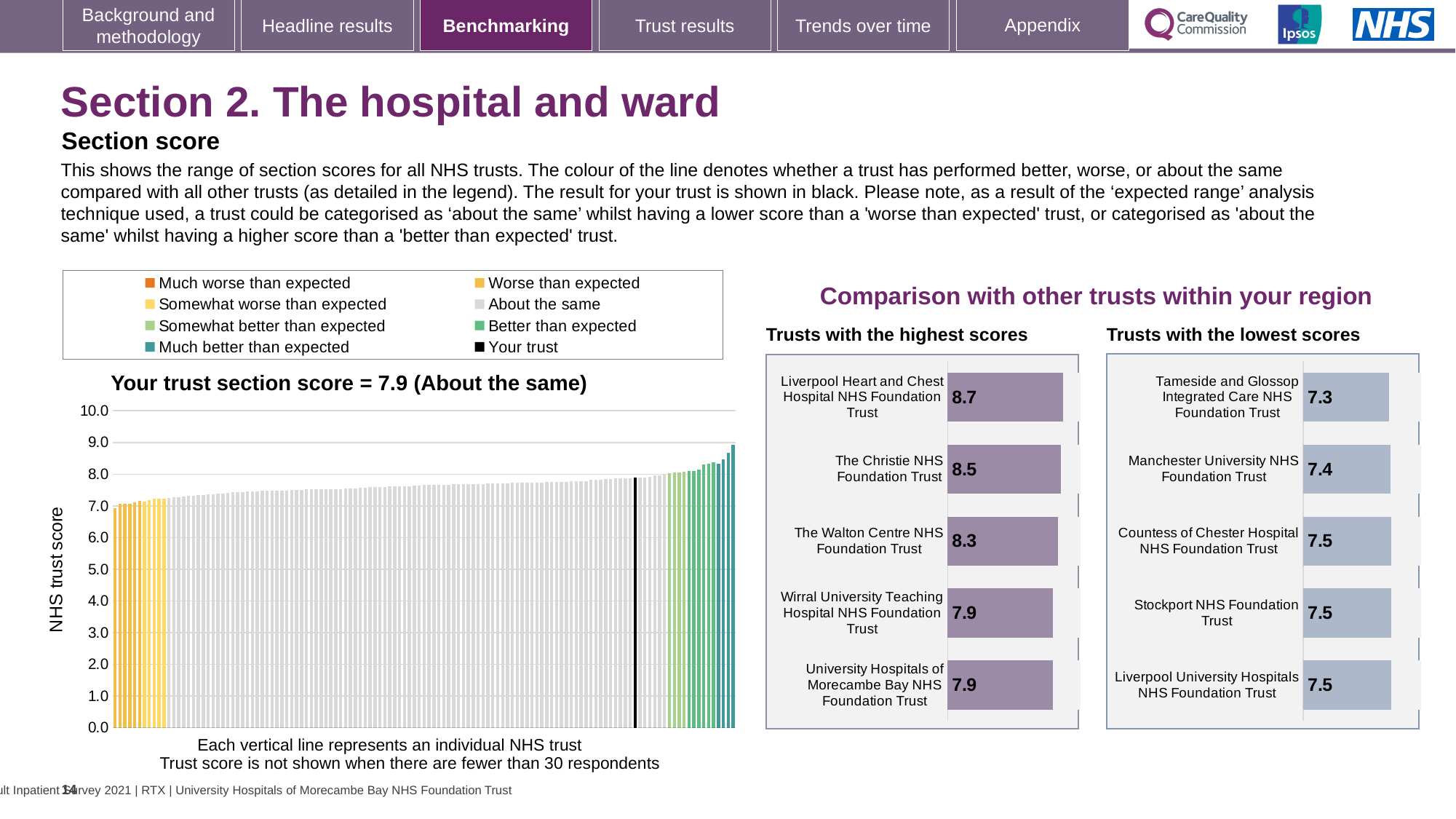
In the main chart on the left, do the trust scores rise or fall from left to right along the x axis? Rise In the 'Trusts with the lowest scores' chart, which is larger: the score for Manchester University NHS Foundation Trust or Countess of Chester Hospital NHS Foundation Trust? Countess of Chester Hospital NHS Foundation Trust In the 'Trusts with the lowest scores' chart, what is the difference between the scores of Stockport NHS Foundation Trust and Tameside and Glossop Integrated Care NHS Foundation Trust? 0.2 In the 'Trusts with the highest scores' chart, which trust has the highest score? Liverpool Heart and Chest Hospital NHS Foundation Trust In the 'Trusts with the lowest scores' chart, what is the score for Manchester University NHS Foundation Trust? 7.4 In the 'Trusts with the highest scores' chart, what is the score for The Christie NHS Foundation Trust? 8.5 In the 'Trusts with the highest scores' chart, what is the score for University Hospitals of Morecambe Bay NHS Foundation Trust? 7.9 In the main chart on the left, what is your trust's section score as stated in the chart title? 7.9 What kind of chart is the main chart on the left showing all NHS trusts? Bar chart In the 'Trusts with the highest scores' chart, how many trusts are shown? 5 In the 'Trusts with the highest scores' chart, what is the difference between the scores of Liverpool Heart and Chest Hospital NHS Foundation Trust and The Walton Centre NHS Foundation Trust? 0.4 In the 'Trusts with the lowest scores' chart, which trust has the lowest score? Tameside and Glossop Integrated Care NHS Foundation Trust